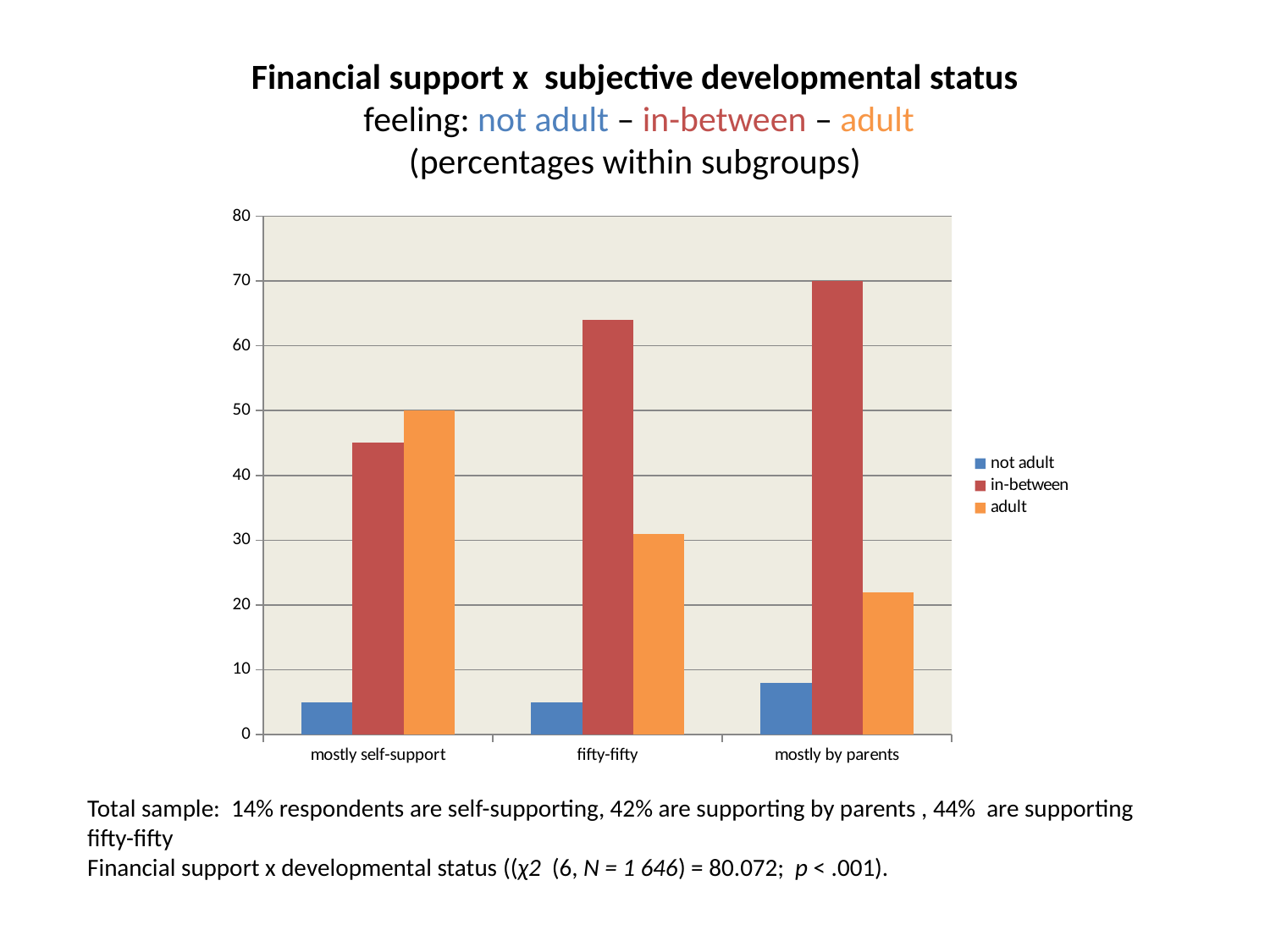
Does the in-between value rise or fall from mostly self-support to mostly by parents? rise How many categories are shown on the x axis? 3 For mostly self-support, which is larger: the in-between value or the adult value? adult Which category has the highest in-between value? mostly by parents Is the in-between value for fifty-fifty greater or less than 60? greater Which category has the lowest adult value? mostly by parents Which series has the lowest value in every category? not adult How many series does the legend list? 3 Is the not adult value for mostly by parents greater or less than 10? less Is the adult value for mostly by parents greater or less than 30? less What kind of chart is shown on the slide? bar chart Which colour represents the in-between series in the legend? red